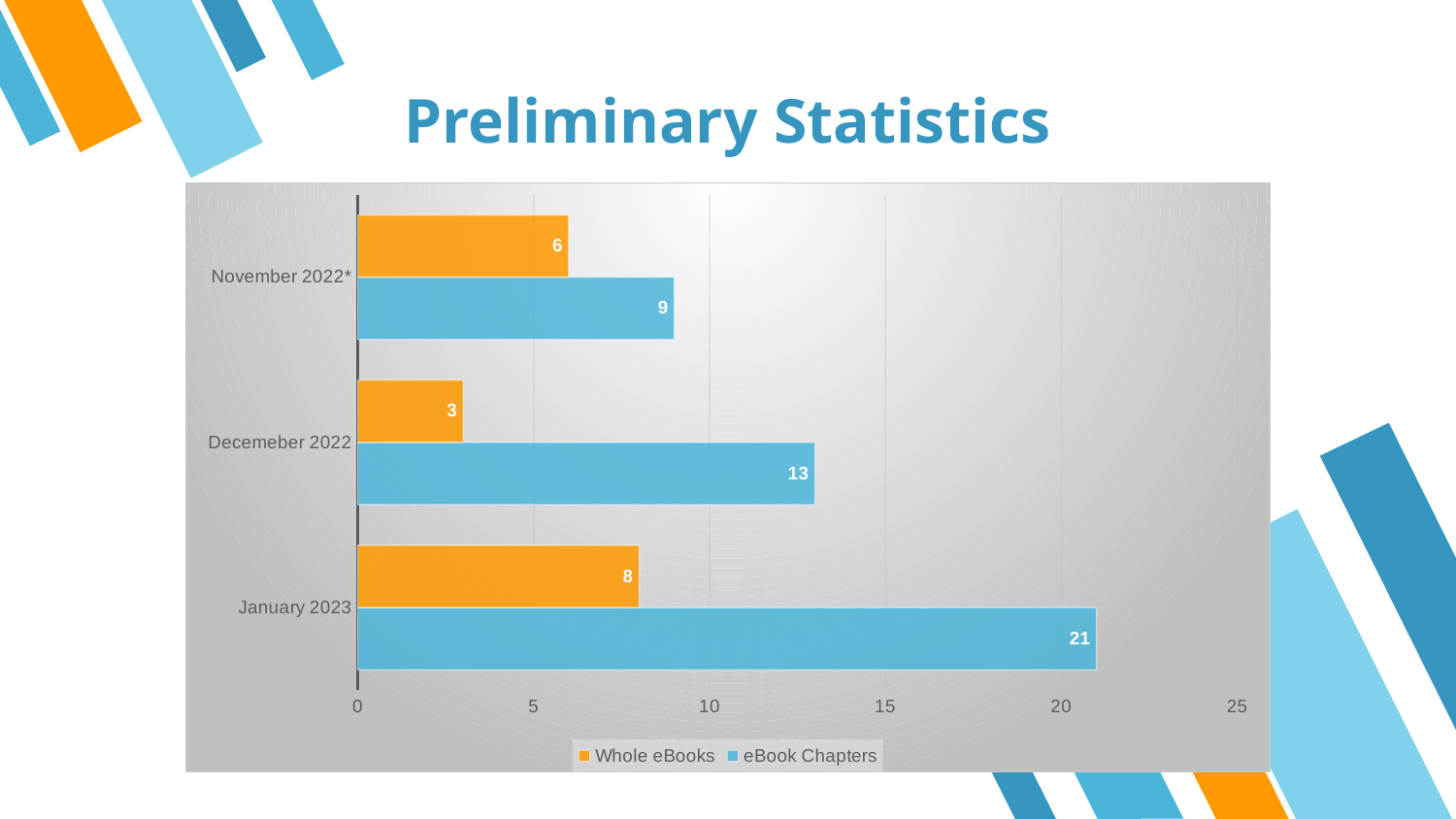
What is the difference between eBook Chapters and Whole eBooks in January 2023? 13 Which category has the highest value for eBook Chapters? January 2023 What kind of chart is shown on the slide? bar chart What colour represents Whole eBooks in the chart? orange How many categories are shown on the chart? 3 What is the value for eBook Chapters in January 2023? 21 What is the value for Whole eBooks in Decemeber 2022? 3 How many series does the legend list? 2 Which category has the lowest value for Whole eBooks? Decemeber 2022 Is the value for eBook Chapters in January 2023 greater or less than 20? greater What is the value for eBook Chapters in November 2022*? 9 Which is larger in Decemeber 2022: Whole eBooks or eBook Chapters? eBook Chapters